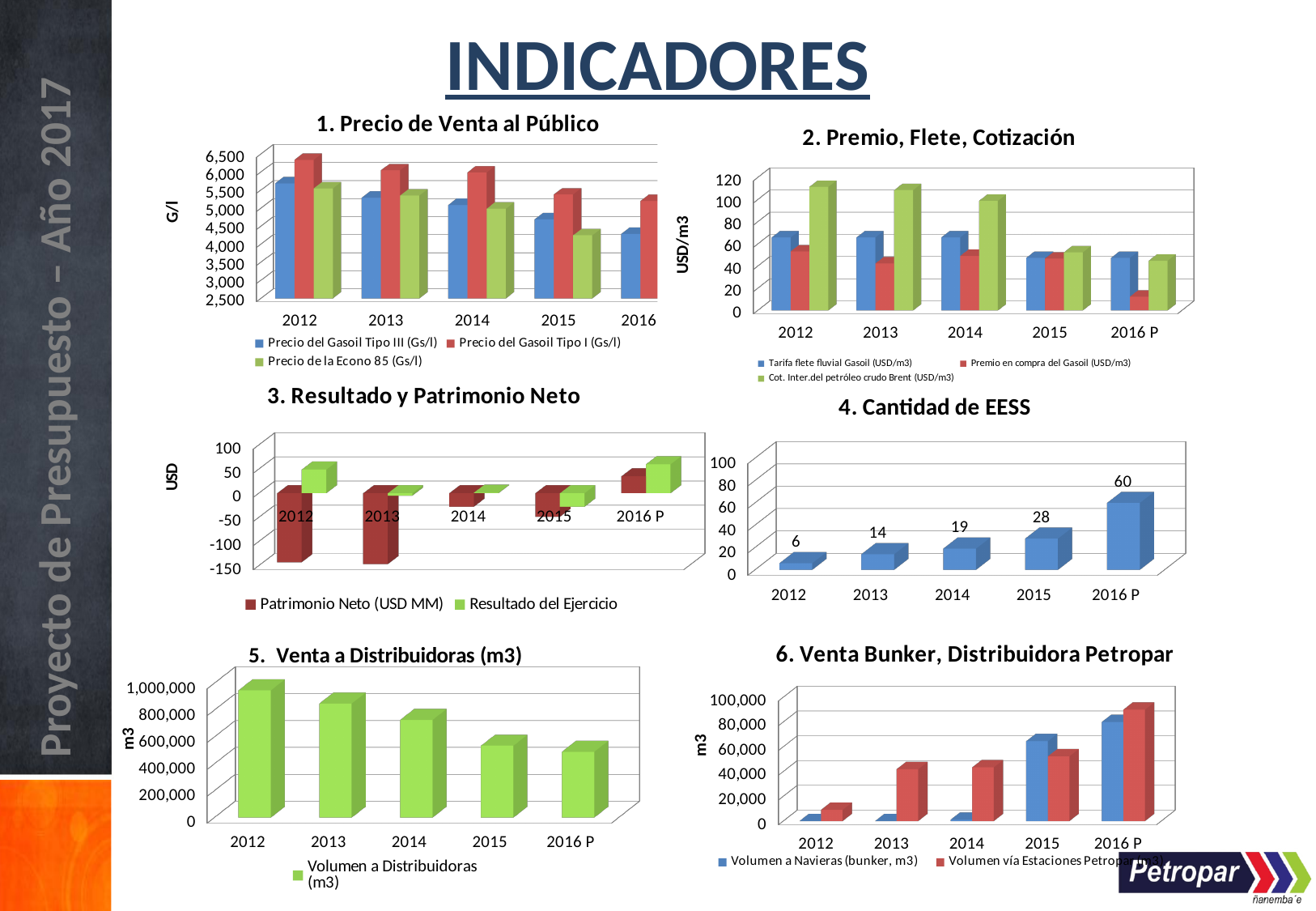
In the chart '1. Precio de Venta al Público', is the value for Precio del Gasoil Tipo I in 2012 greater or less than 6,000? greater How many series does the legend of the chart '2. Premio, Flete, Cotización' list? 3 In the chart '4. Cantidad de EESS', what is the value for 2016 P? 60 What kind of chart is '5. Venta a Distribuidoras (m3)'? bar chart In the chart '4. Cantidad de EESS', what is the value for 2012? 6 In the chart '4. Cantidad de EESS', do the values rise or fall from 2012 to 2016 P? rise In the chart '6. Venta Bunker, Distribuidora Petropar', which series has the larger value in 2013: Volumen a Navieras (bunker, m3) or Volumen vía Estaciones Petropar (m3)? Volumen vía Estaciones Petropar (m3) How many series does the legend of the chart '1. Precio de Venta al Público' list? 3 In the chart '4. Cantidad de EESS', which year has the highest value? 2016 P In the chart '5. Venta a Distribuidoras (m3)', is the value for 2012 greater or less than 800,000? greater In the chart '5. Venta a Distribuidoras (m3)', do the values rise or fall from 2012 to 2016 P? fall In the chart '4. Cantidad de EESS', what is the difference between the values for 2016 P and 2015? 32